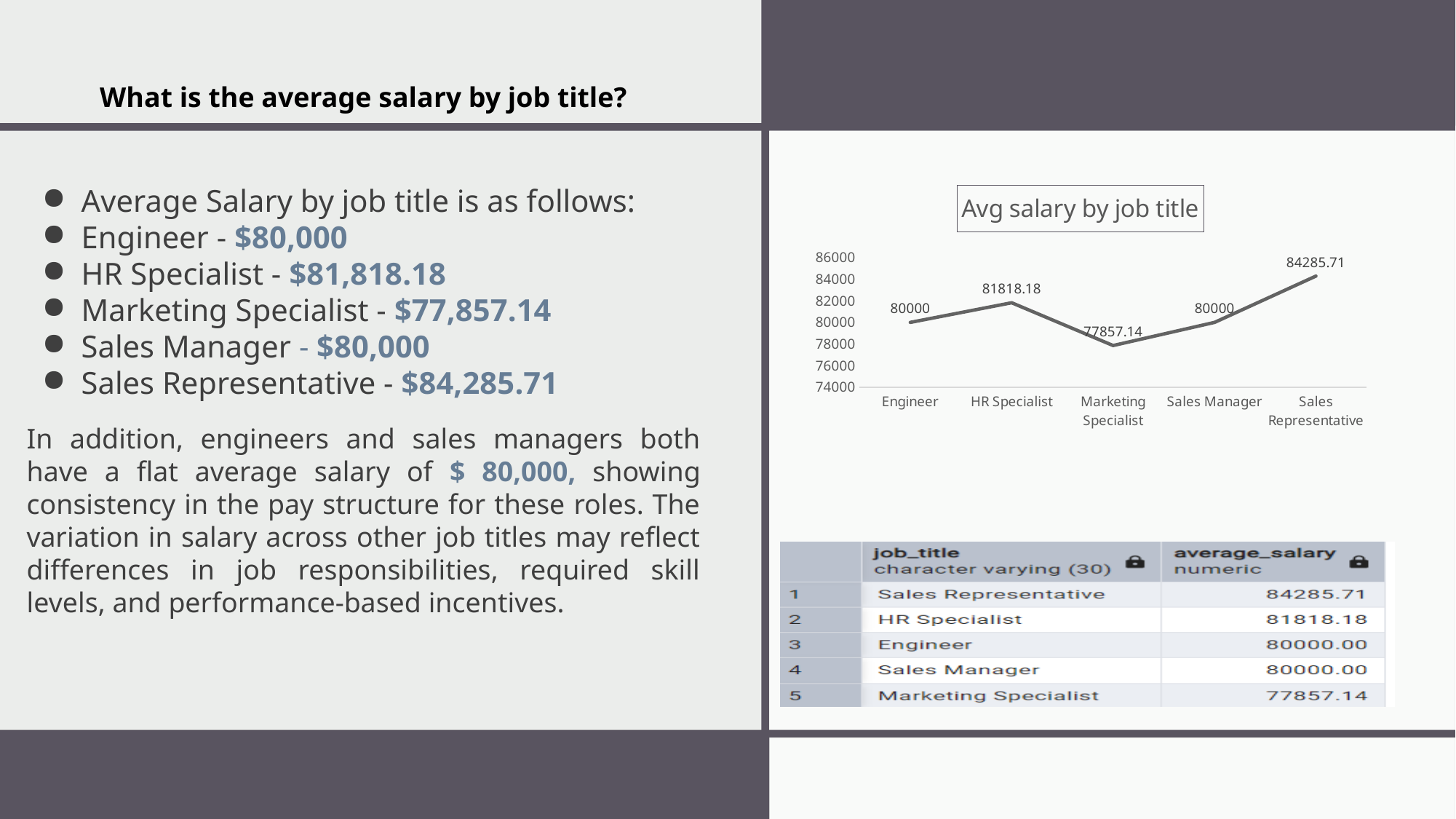
What is the value for Engineer in the chart? 80000 Is the value for Marketing Specialist greater or less than 80000? less What is the title of the chart? Avg salary by job title Which job title has the highest average salary in the chart? Sales Representative What is the difference between the values for Sales Representative and Marketing Specialist? 6428.57 What is the value for HR Specialist in the chart? 81818.18 What is the value for Sales Representative in the chart? 84285.71 Which job title has the lowest average salary in the chart? Marketing Specialist What is the value for Marketing Specialist in the chart? 77857.14 What kind of chart is shown on the slide? line chart How many job titles are plotted on the x axis of the chart? 5 Which is larger, the value for HR Specialist or the value for Sales Manager? HR Specialist